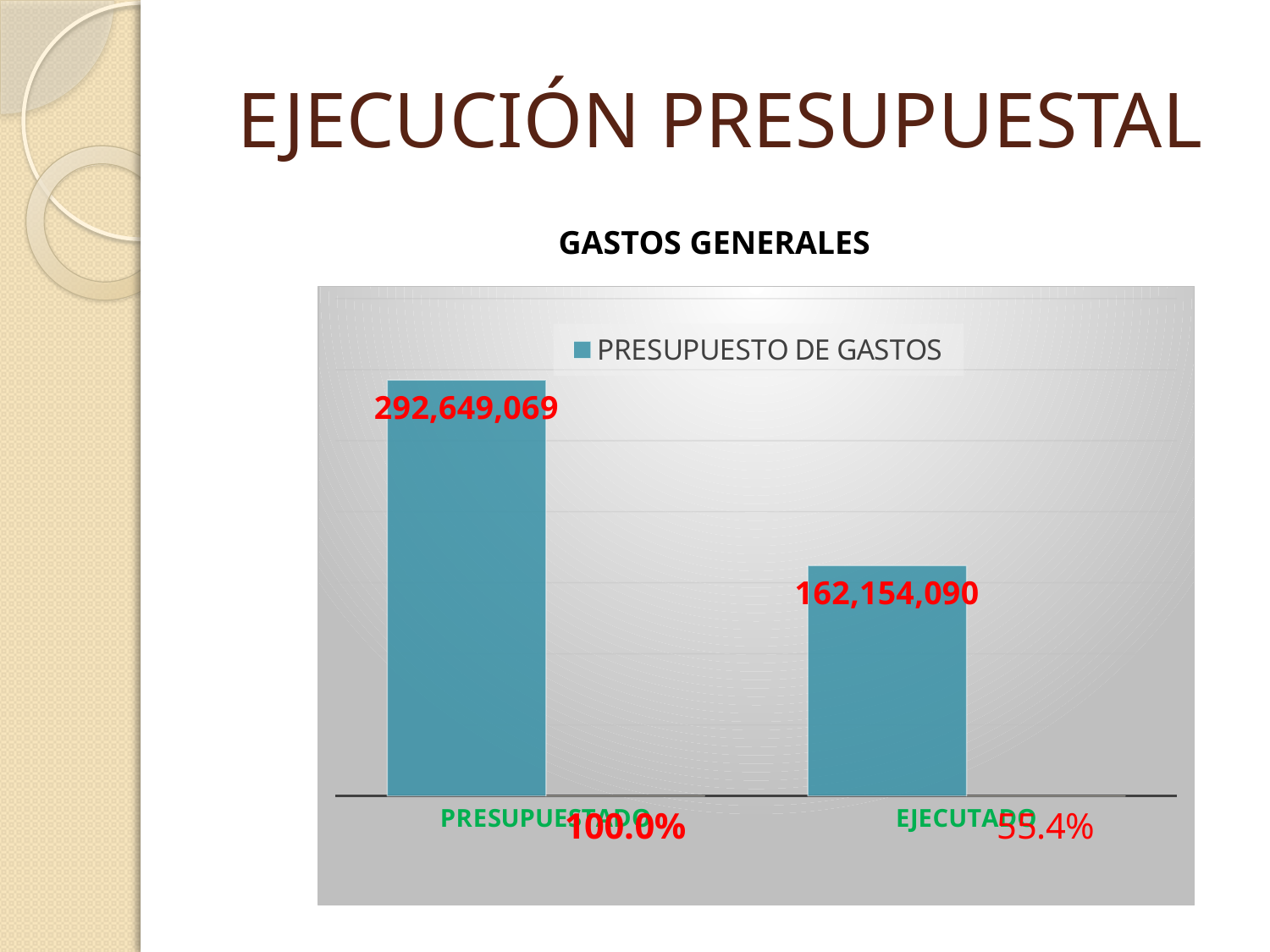
What percentage is shown below the EJECUTADO bar? 55.4% Which is larger, the value for PRESUPUESTADO or the value for EJECUTADO? PRESUPUESTADO How many series does the legend list? 1 Which category has the lowest value? EJECUTADO Which category has the highest value? PRESUPUESTADO What type of chart is shown on the slide? bar chart What is the value for PRESUPUESTADO? 292,649,069 What is the value for EJECUTADO? 162,154,090 What series does the legend list? PRESUPUESTO DE GASTOS How many bars are plotted in the chart? 2 What is the difference between the PRESUPUESTADO value and the EJECUTADO value? 130,494,979 What is the title of the chart? GASTOS GENERALES